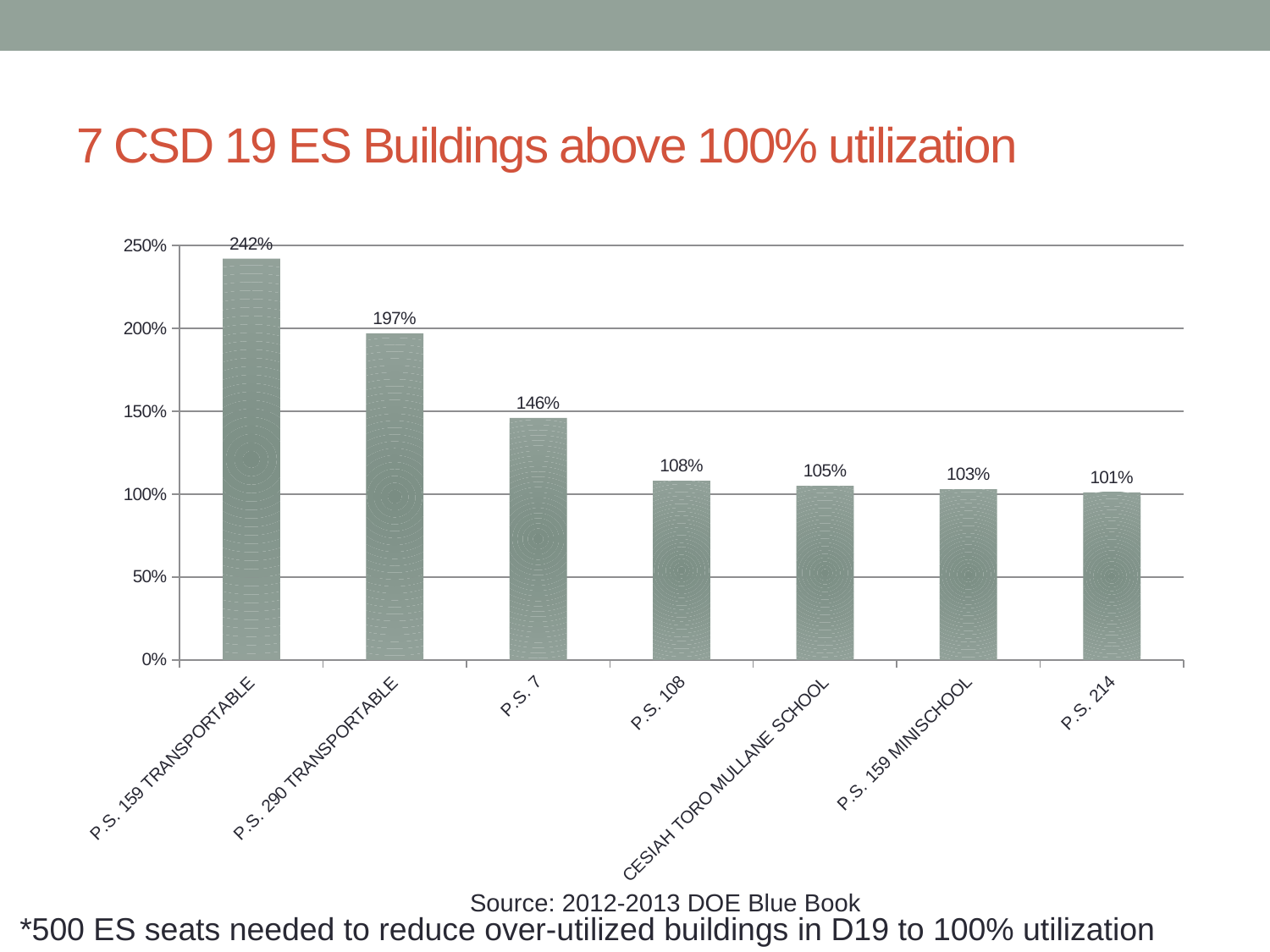
Which has a higher utilization, P.S. 108 or P.S. 159 MINISCHOOL? P.S. 108 Which building has the lowest utilization? P.S. 214 What is the difference in utilization between P.S. 159 TRANSPORTABLE and P.S. 290 TRANSPORTABLE? 45% Which building has the highest utilization? P.S. 159 TRANSPORTABLE What is the utilization value for P.S. 7? 146% Do the values rise or fall from left to right along the x axis? Fall What is the utilization value for P.S. 159 TRANSPORTABLE? 242% What is the utilization value for P.S. 214? 101% Is the value for P.S. 290 TRANSPORTABLE greater or less than 150%? greater What kind of chart is shown on the slide? Bar chart How many buildings are shown in the chart? 7 What is the utilization value for CESIAH TORO MULLANE SCHOOL? 105%